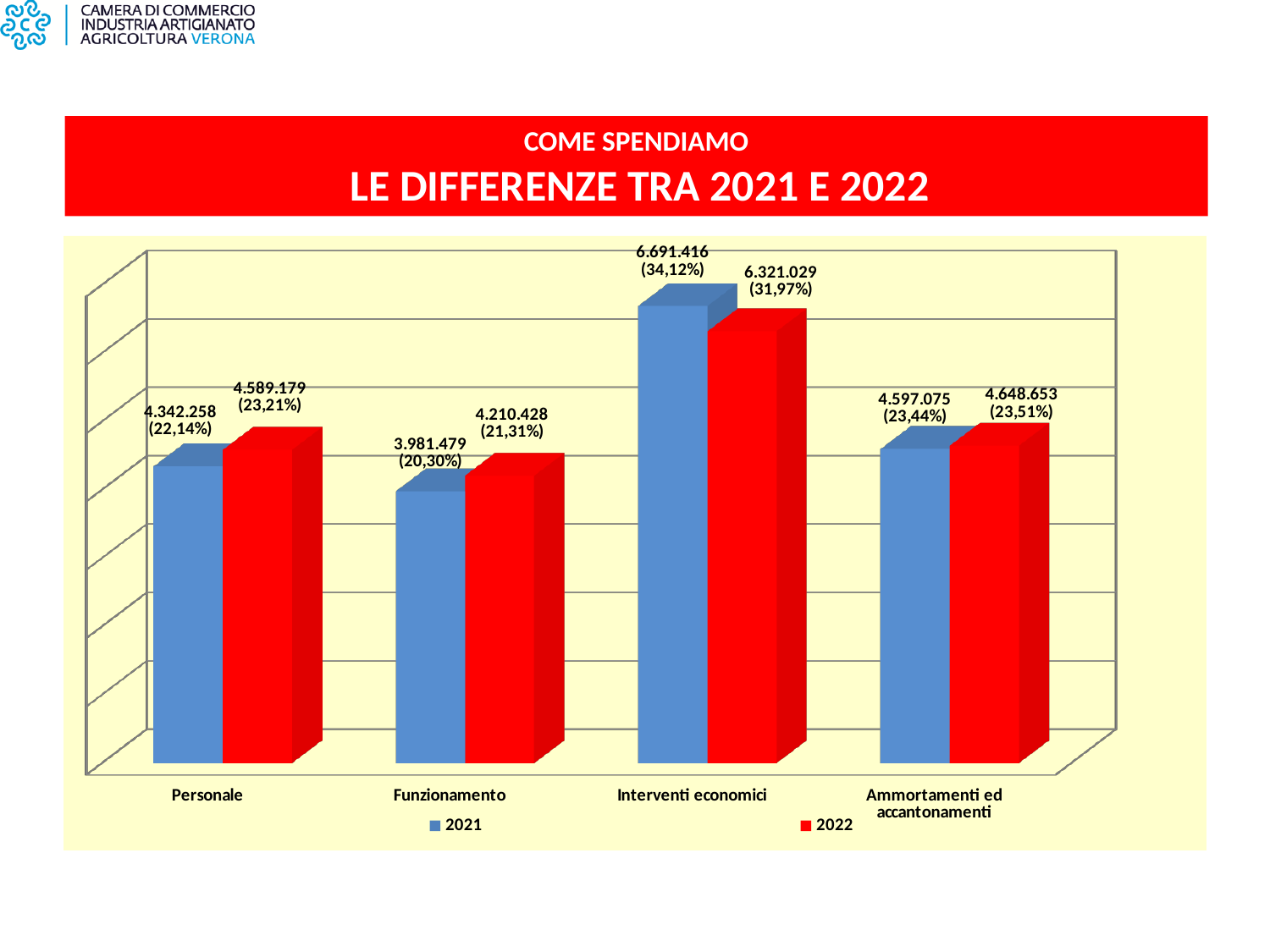
What percentage is shown for Funzionamento in 2022? 21,31% Which category has the highest value in 2021? Interventi economici What type of chart is shown on the slide? Bar chart What is the 2022 value for Interventi economici? 6.321.029 What is the difference between the 2022 and 2021 values for Personale? 246.921 How many series does the legend list? 2 Which category has the lowest value in 2022? Funzionamento What is the 2021 value for Personale? 4.342.258 How many categories are shown on the x axis? 4 Which is larger for Funzionamento, the 2021 value or the 2022 value? 2022 What is the 2021 value for Ammortamenti ed accantonamenti? 4.597.075 By how much did Interventi economici decrease from 2021 to 2022? 370.387